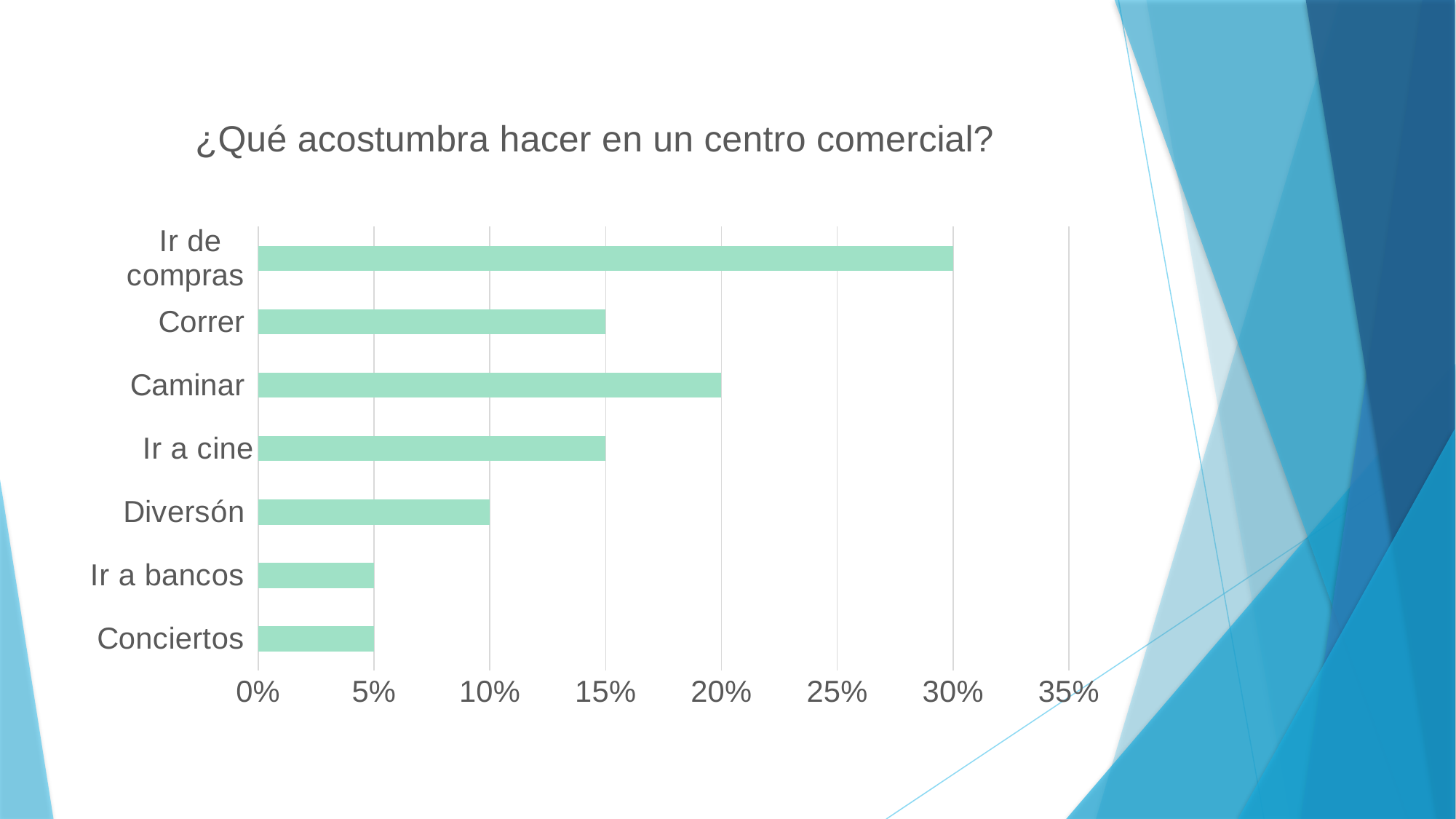
What is the value for Ir de compras? 30% Is the value for Conciertos greater or less than 10%? less What is the value for Ir a bancos? 5% Which is larger, the value for Caminar or the value for Correr? Caminar How many categories are shown in the chart? 7 What type of chart is shown on the slide? bar chart What is the value for Caminar? 20% What is the title of the chart? ¿Qué acostumbra hacer en un centro comercial? What is the value for Diversón? 10% Which category has the highest value? Ir de compras Is the value for Ir a cine greater or less than 10%? greater What is the difference between the values for Ir de compras and Caminar? 10%